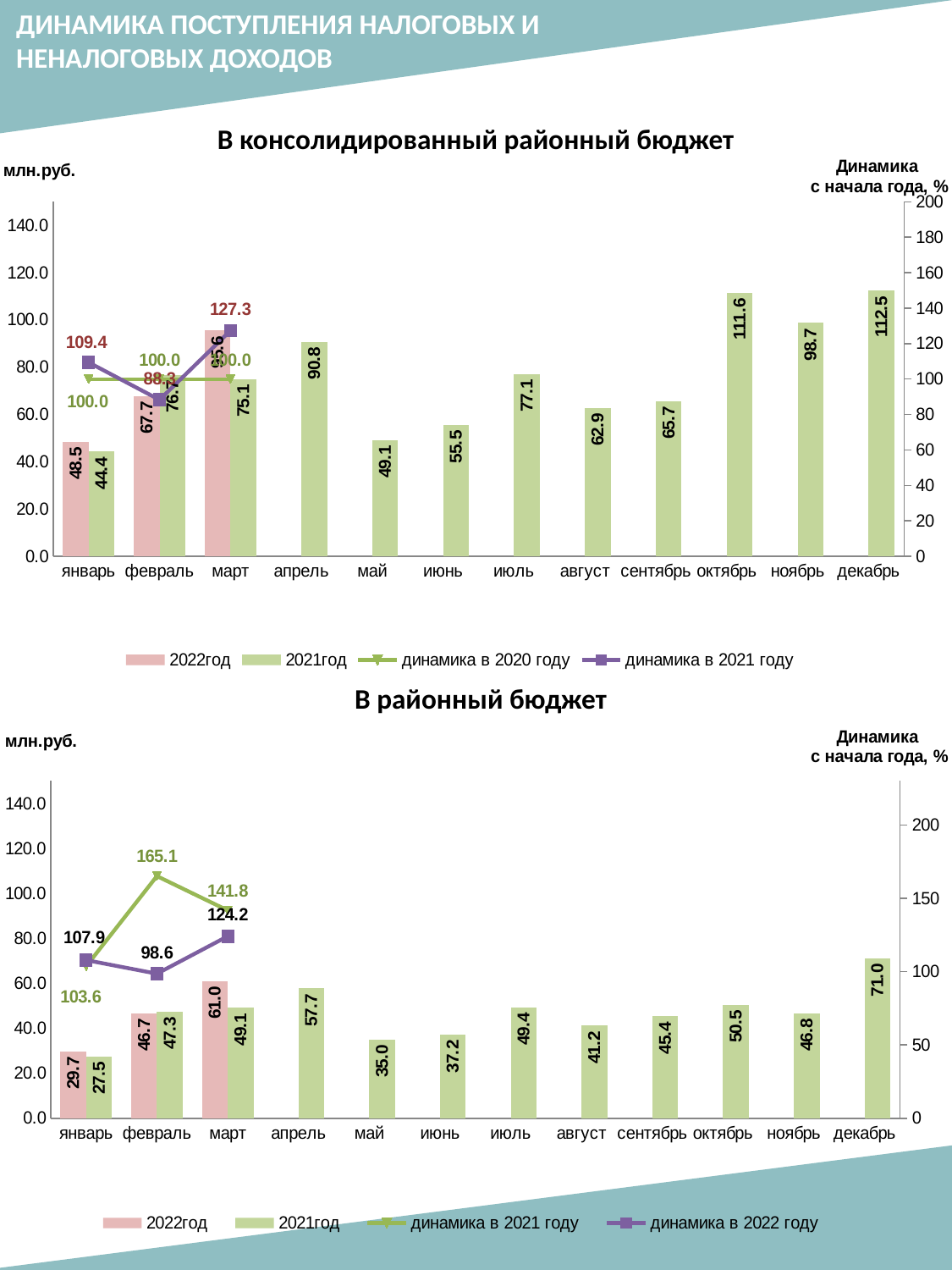
In the chart 'В консолидированный районный бюджет', what is the value of the 2022год bar for март? 95.6 In the chart 'В консолидированный районный бюджет', what is the difference between the 2022год and 2021год bars for январь? 4.1 In the chart 'В районный бюджет', what is the value of the 2022год bar for март? 61.0 In the chart 'В консолидированный районный бюджет', what is the value of the 2021год bar for декабрь? 112.5 How many series does the legend of the chart 'В консолидированный районный бюджет' list? 4 How many months are shown on the x axis of the chart 'В районный бюджет'? 12 In the chart 'В районный бюджет', what is the difference between the 2022год and 2021год bars for март? 11.9 In the chart 'В консолидированный районный бюджет', what is the value of the 'динамика в 2021 году' line for март? 127.3 In the chart 'В районный бюджет', which month has the highest 2021год bar? декабрь In the chart 'В консолидированный районный бюджет', which month has the lowest 2021год bar? январь In the chart 'В районный бюджет', what is the value of the 'динамика в 2021 году' line for февраль? 165.1 In the chart 'В районный бюджет', which is larger for февраль: the 2022год bar or the 2021год bar? 2021год